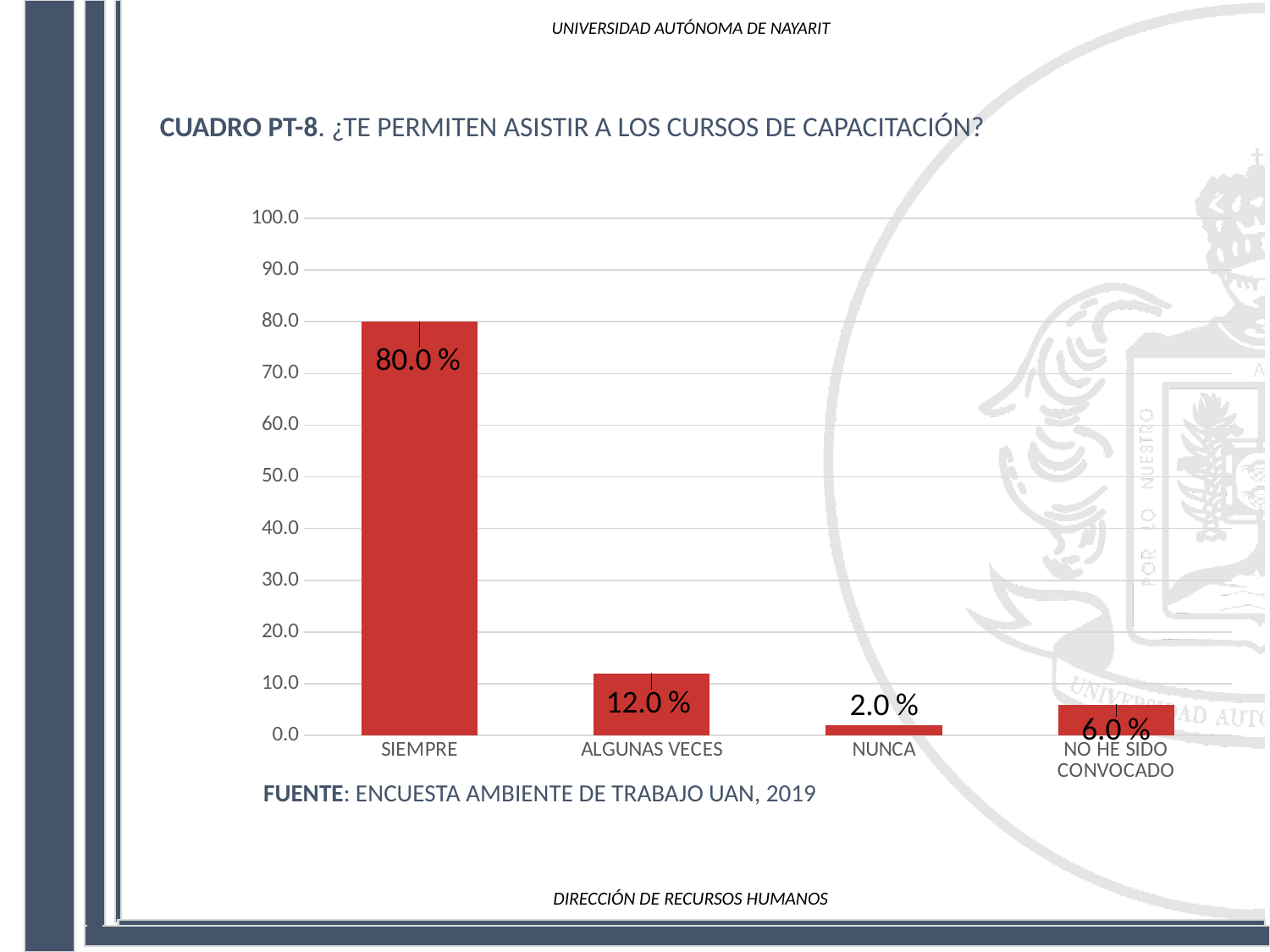
Which category has the lowest value? NUNCA What source is cited below the chart? ENCUESTA AMBIENTE DE TRABAJO UAN, 2019 What is the value for SIEMPRE? 80.0 % Which category has the highest value? SIEMPRE What kind of chart is shown on the slide? Bar chart What is the value for ALGUNAS VECES? 12.0 % Is the value for ALGUNAS VECES greater or less than 10.0? greater What is the value for NO HE SIDO CONVOCADO? 6.0 % How many categories are shown on the x axis? 4 What is the difference between the values for SIEMPRE and ALGUNAS VECES? 68.0 % What is the value for NUNCA? 2.0 % Which is larger, the value for NO HE SIDO CONVOCADO or the value for NUNCA? NO HE SIDO CONVOCADO